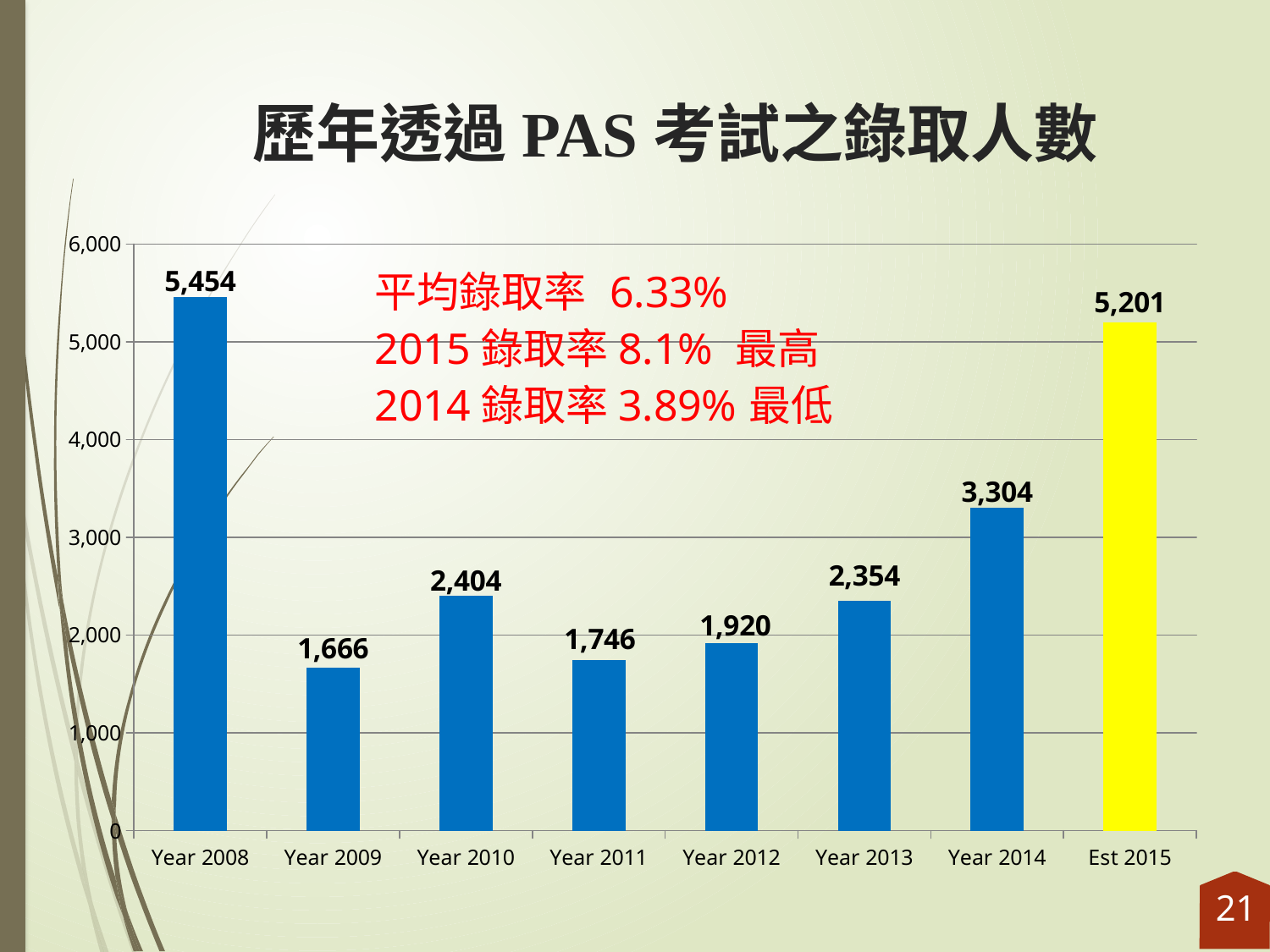
What is the value for Year 2011? 1,746 Which bar is coloured yellow instead of blue? Est 2015 Which category has the lowest value? Year 2009 Do the values rise or fall from Year 2011 to Year 2014? rise What is the value for Year 2008? 5,454 How many categories are shown on the x axis? 8 Which is larger, the value for Year 2010 or the value for Year 2012? Year 2010 Which category has the highest value? Year 2008 What kind of chart is shown on the slide? bar chart Is the value for Year 2014 greater or less than 3,000? greater What is the difference between the values for Year 2014 and Year 2013? 950 What is the value for Est 2015? 5,201